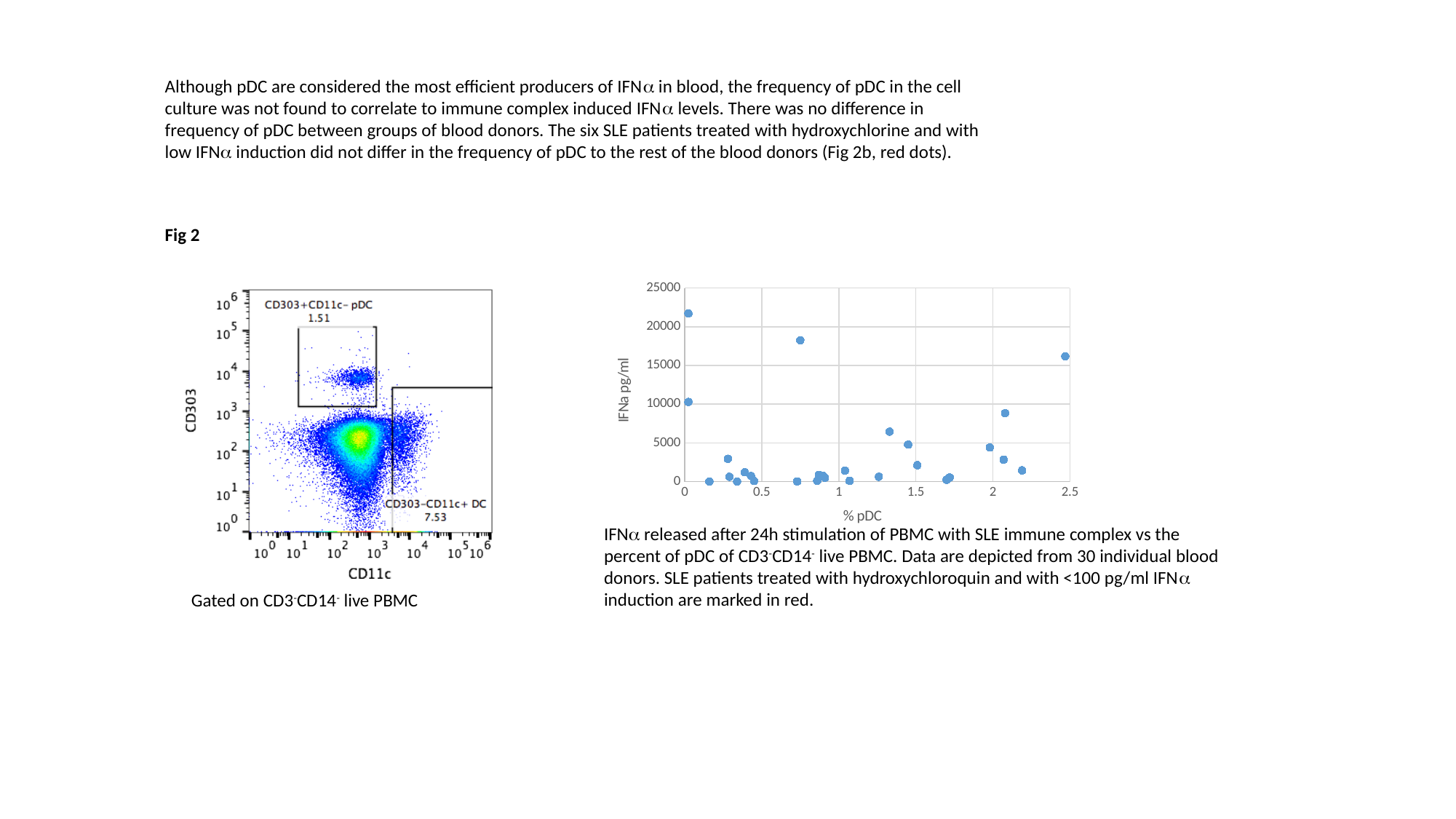
What kind of chart is the chart on the right of the slide (IFNa pg/ml vs % pDC)? scatter chart On the right-hand scatter chart, is the point at about 2.05 % pDC greater or less than 10000 pg/ml? less On the right-hand scatter chart, what is the label of the y axis? IFNa pg/ml In the left-hand flow cytometry plot, what is the difference between the CD303−CD11c+ DC gate percentage and the CD303+CD11c− pDC gate percentage? 6.02 On the right-hand scatter chart, what is the label of the x axis? % pDC On the right-hand scatter chart, is the point at about 0.75 % pDC greater or less than 20000 pg/ml? less On the right-hand scatter chart, is the point at about 2.5 % pDC greater or less than 15000 pg/ml? greater According to the caption, how many individual blood donors are plotted in the right-hand scatter chart? 30 In the left-hand flow cytometry plot, what percentage is printed for the CD303−CD11c+ DC gate? 7.53 In the left-hand flow cytometry plot, what percentage is printed for the CD303+CD11c− pDC gate? 1.51 On the right-hand scatter chart, what is the maximum value shown on the y axis? 25000